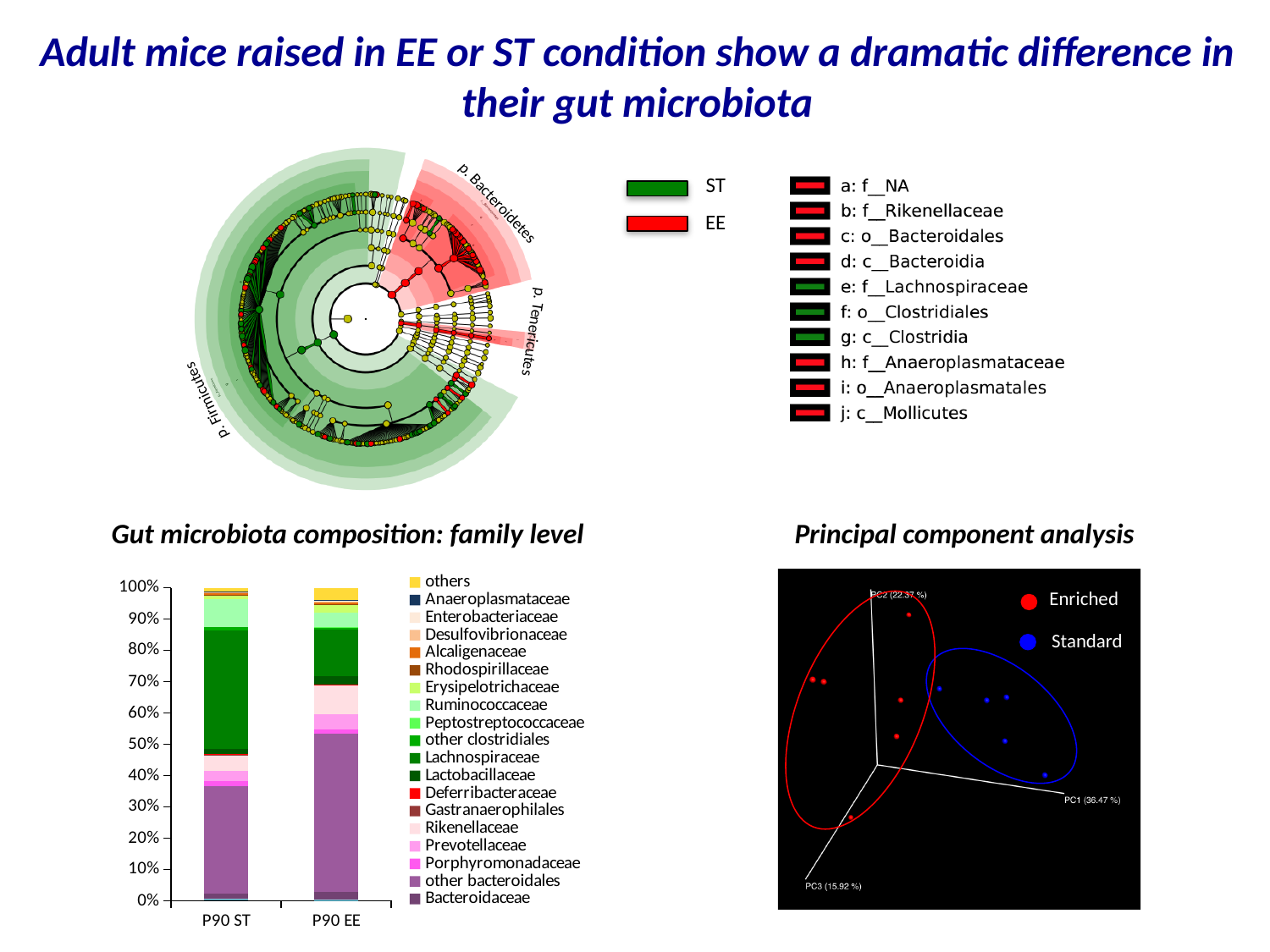
How many series does the legend of the 'Gut microbiota composition: family level' chart list? 19 What are the two category labels on the x axis of the 'Gut microbiota composition: family level' chart? P90 ST and P90 EE In the 'Gut microbiota composition: family level' chart, which bar has the larger 'other bacteroidales' segment, P90 ST or P90 EE? P90 EE In the 'Gut microbiota composition: family level' chart, is the top of the 'other bacteroidales' segment for P90 ST greater or less than 40%? less In the 'Principal component analysis' chart, which group is plotted in blue according to the legend? Standard In the 'Principal component analysis' chart, what percentage of variance is shown for PC1? 36.47 % What kind of chart is the 'Gut microbiota composition: family level' chart? stacked bar chart In the 'Gut microbiota composition: family level' chart, which bar has the larger 'Lachnospiraceae' segment, P90 ST or P90 EE? P90 ST How many categories (bars) are shown on the x axis of the 'Gut microbiota composition: family level' chart? 2 In the 'Principal component analysis' chart, what percentage of variance is shown for PC2? 22.37 % What kind of chart is the 'Principal component analysis' chart? scatter plot In the 'Gut microbiota composition: family level' chart, is the top of the 'other bacteroidales' segment for P90 EE greater or less than 40%? greater